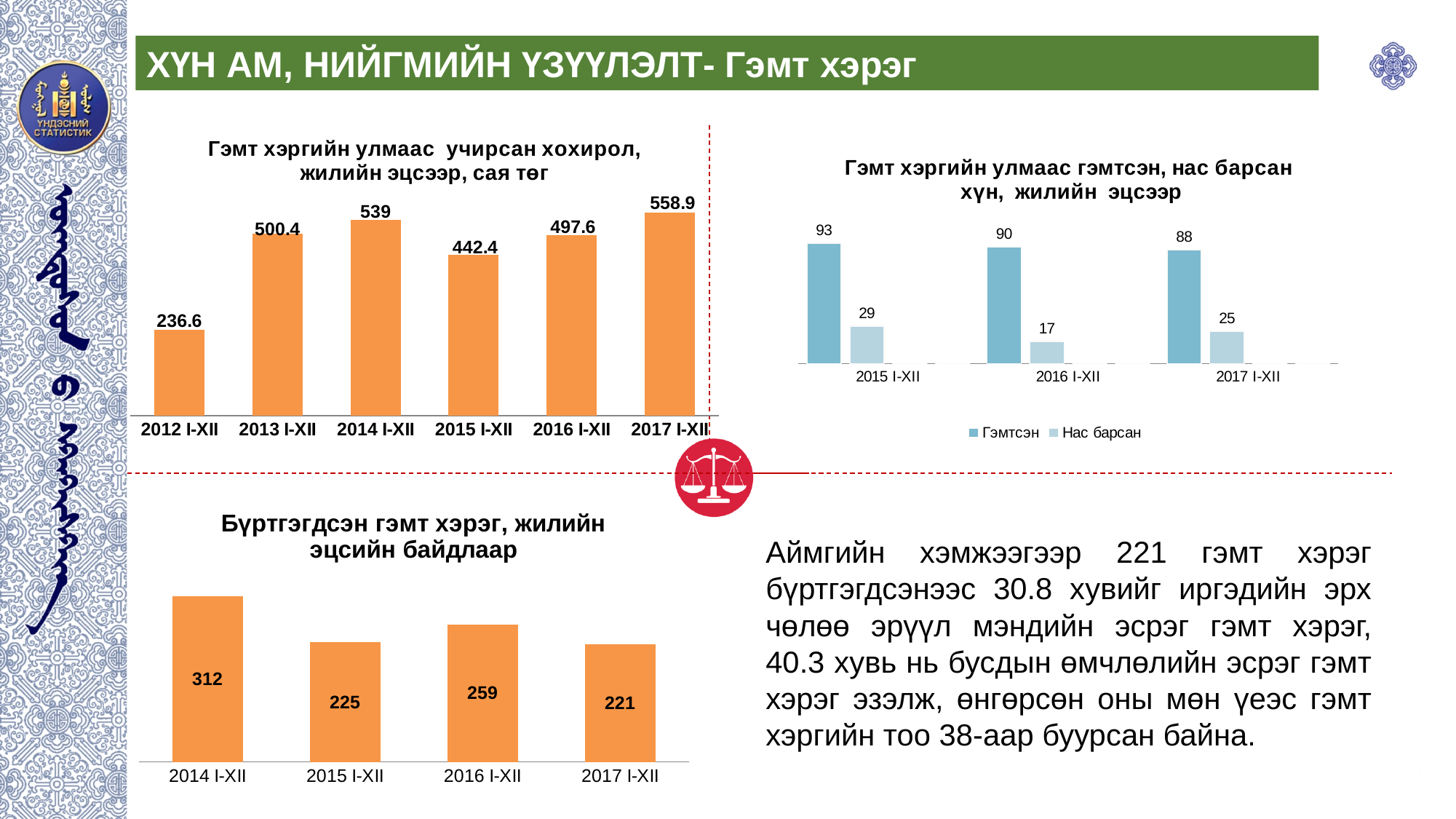
In the top-left chart (Гэмт хэргийн улмаас учирсан хохирол), which year has the lowest value? 2012 I-XII What kind of chart is the bottom-left chart (Бүртгэгдсэн гэмт хэрэг)? bar chart In the top-left chart (Гэмт хэргийн улмаас учирсан хохирол), what is the difference between the 2017 I-XII and 2012 I-XII values? 322.3 In the top-right chart (Гэмт хэргийн улмаас гэмтсэн, нас барсан хүн), what is the Гэмтсэн value for 2015 I-XII? 93 In the top-right chart (Гэмт хэргийн улмаас гэмтсэн, нас барсан хүн), what is the Нас барсан value for 2016 I-XII? 17 In the bottom-left chart (Бүртгэгдсэн гэмт хэрэг), what is the difference between the 2014 I-XII and 2017 I-XII values? 91 In the top-left chart (Гэмт хэргийн улмаас учирсан хохирол), how many years are shown? 6 In the top-right chart (Гэмт хэргийн улмаас гэмтсэн, нас барсан хүн), does the Гэмтсэн series rise or fall from 2015 I-XII to 2017 I-XII? fall In the top-right chart (Гэмт хэргийн улмаас гэмтсэн, нас барсан хүн), how many series does the legend list? 2 In the top-left chart (Гэмт хэргийн улмаас учирсан хохирол), what is the value for 2014 I-XII? 539 In the bottom-left chart (Бүртгэгдсэн гэмт хэрэг), what is the value for 2016 I-XII? 259 In the top-left chart (Гэмт хэргийн улмаас учирсан хохирол), which year has the highest value? 2017 I-XII